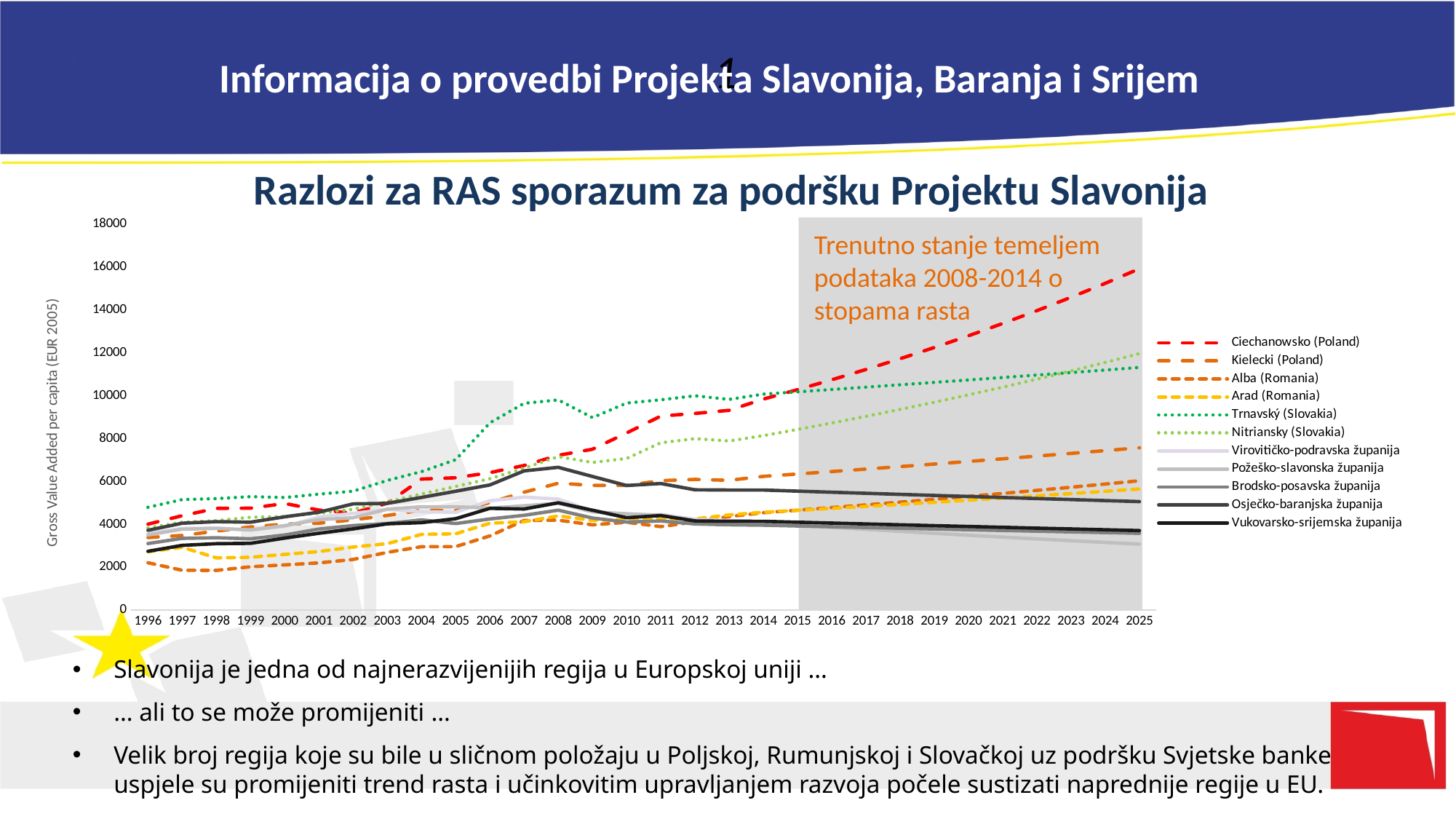
In 2025, which is larger: the value for Ciechanowsko (Poland) or the value for Osječko-baranjska županija? Ciechanowsko (Poland) Is the value for Trnavský (Slovakia) in 2025 greater or less than 10000? greater Does the value for Ciechanowsko (Poland) rise or fall from 2015 to 2025? rise How many years are shown along the x axis of the chart? 30 How many series does the chart's legend list? 11 Is the value for Ciechanowsko (Poland) in 2025 greater or less than 14000? greater What is the label of the vertical axis of the chart? Gross Value Added per capita (EUR 2005) What is the first year shown on the x axis of the chart? 1996 What kind of chart is shown on the slide? line chart Is the value for Kielecki (Poland) in 2025 greater or less than 6000? greater Which series has the highest value in 2025? Ciechanowsko (Poland)